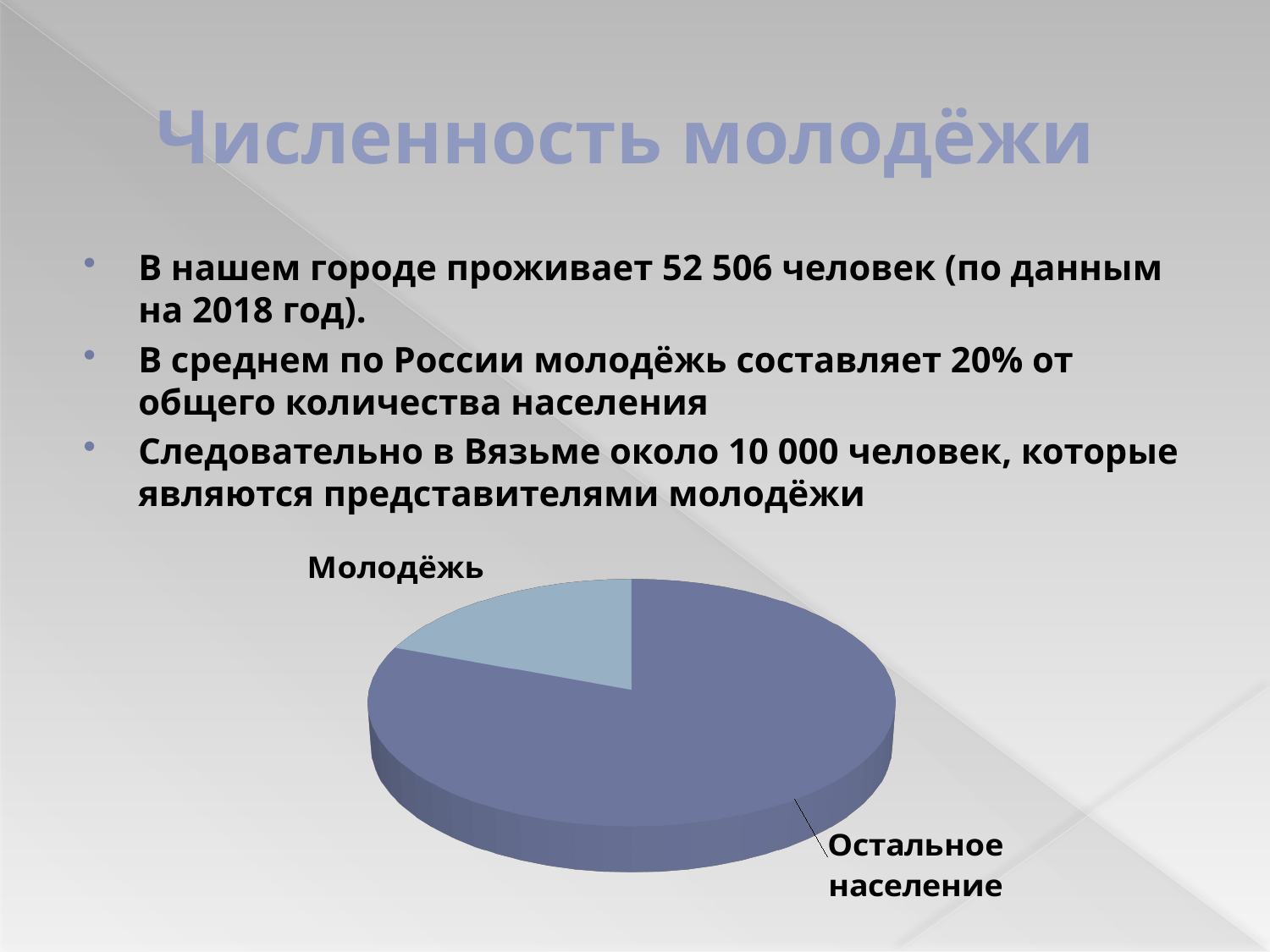
What colour is the Молодёжь slice in the pie chart? light blue Which slice is larger in the pie chart, Молодёжь or Остальное население? Остальное население Which slice of the pie chart is the largest? Остальное население How many slices does the pie chart have? 2 What kind of chart is shown on the slide? pie chart Does the slice for Молодёжь take up more or less than half of the pie? less What are the labels of the two slices in the pie chart? Молодёжь and Остальное население Which slice of the pie chart is the smallest? Молодёжь